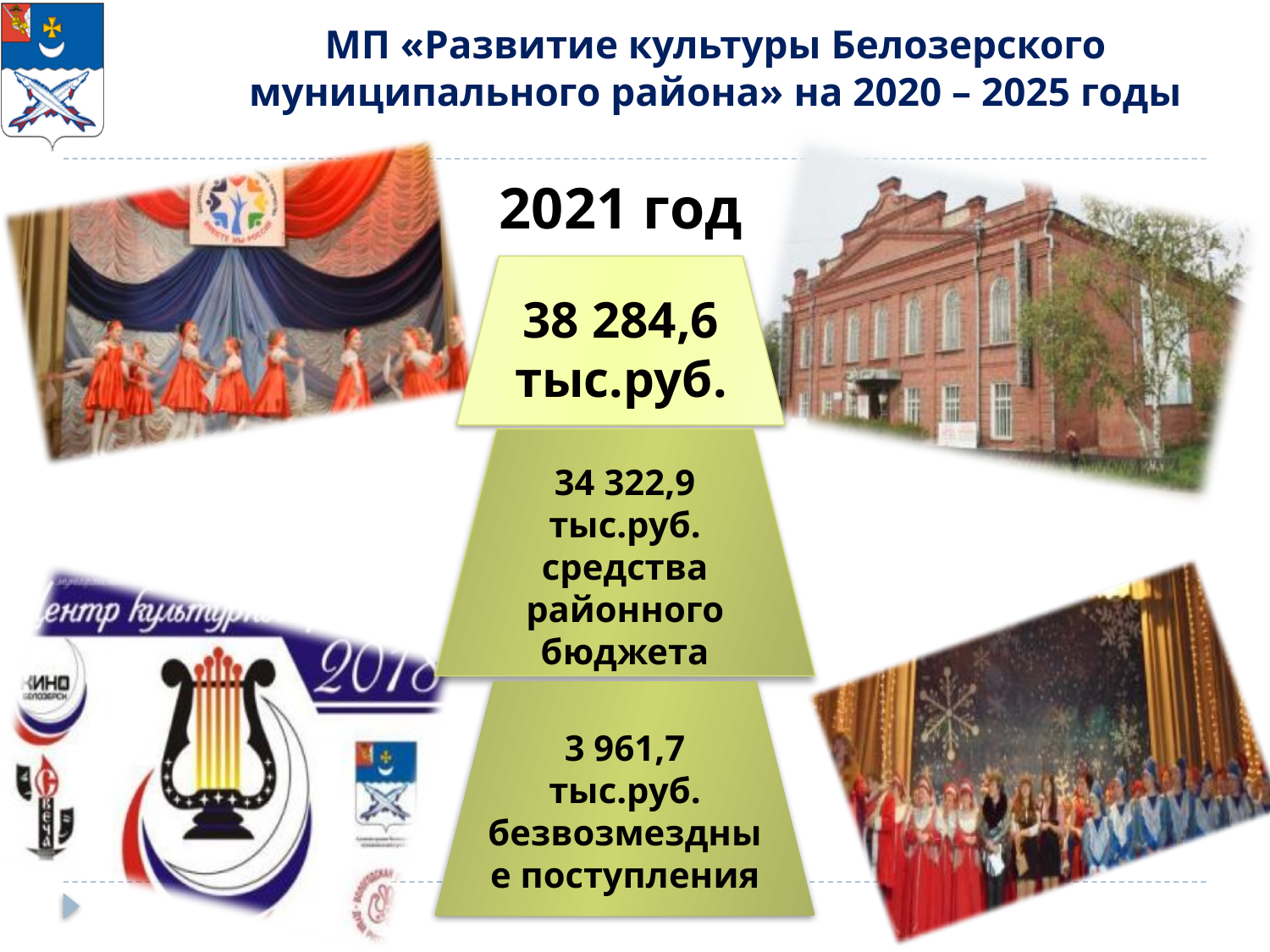
What is the sum of district budget funds and gratuitous receipts shown in the pyramid? 38 284,6 тыс.руб. Which year does the pyramid diagram refer to? 2021 год What is the difference between district budget funds and gratuitous receipts in 2021? 30 361,2 тыс.руб. What is the title of the programme shown at the top of the slide? МП «Развитие культуры Белозерского муниципального района» на 2020 – 2025 годы What total amount is shown at the top of the pyramid for 2021? 38 284,6 тыс.руб. How much of the 2021 funding comes from gratuitous receipts (безвозмездные поступления)? 3 961,7 тыс.руб. How many funding sources are listed below the total in the pyramid? 2 Which funding source is larger in 2021: district budget funds or gratuitous receipts? средства районного бюджета Which funding source is the smallest in the 2021 pyramid? безвозмездные поступления How much of the 2021 funding comes from the district budget (средства районного бюджета)? 34 322,9 тыс.руб.